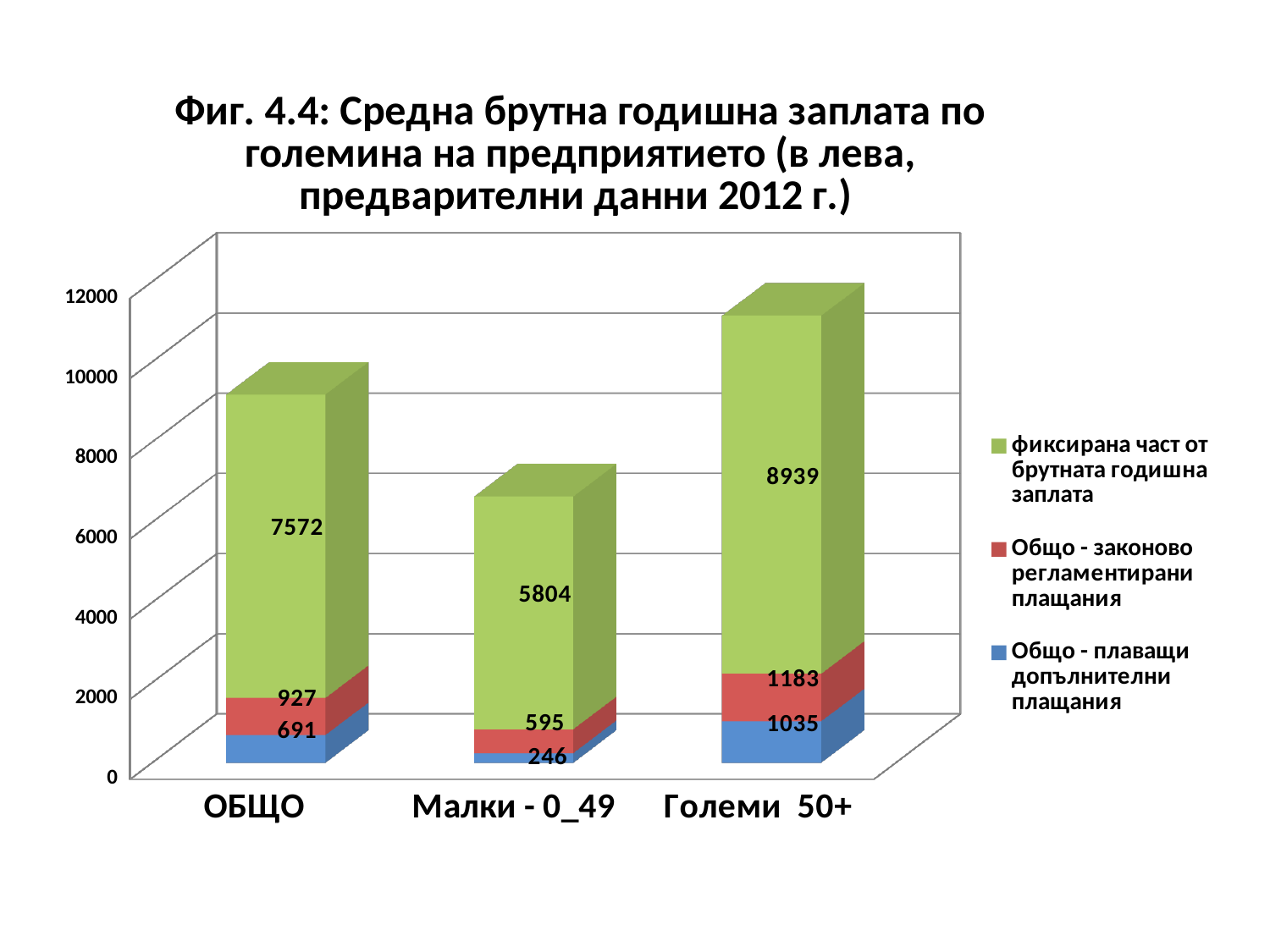
What is the difference between the fixed part of gross annual salary for Големи 50+ and for Малки - 0_49? 3135 What is the value of Общо - плаващи допълнителни плащания for ОБЩО? 691 Which is larger: Общо - законово регламентирани плащания for ОБЩО or for Големи 50+? Големи 50+ What is the total of the stacked bar for Големи 50+? 11157 Which category has the highest value for the fixed part of gross annual salary? Големи 50+ Which category has the lowest value for Общо - плаващи допълнителни плащания? Малки - 0_49 What kind of chart is shown on the slide? Stacked bar chart What is the value of the fixed part of gross annual salary (фиксирана част от брутната годишна заплата) for Големи 50+? 8939 What is the total of the stacked bar for Малки - 0_49? 6645 How many categories are shown on the x axis? 3 How many series does the legend list? 3 What is the value of Общо - законово регламентирани плащания for Малки - 0_49? 595